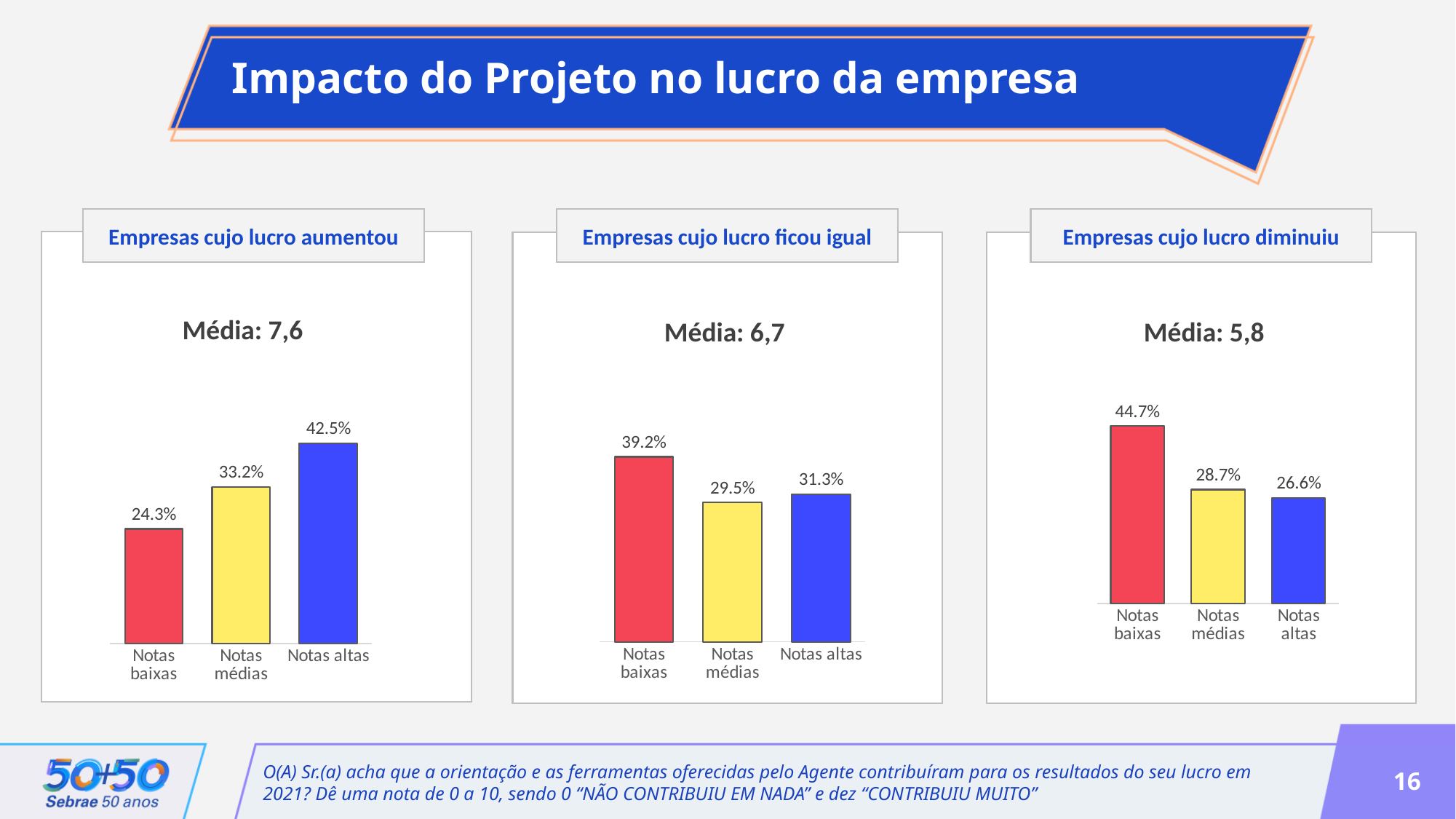
In the chart 'Empresas cujo lucro aumentou', which category has the highest value? Notas altas In the chart 'Empresas cujo lucro aumentou', what is the value for Notas altas? 42.5% In the chart 'Empresas cujo lucro ficou igual', which category has the highest value? Notas baixas How many categories does the chart 'Empresas cujo lucro aumentou' show? 3 What kind of chart is 'Empresas cujo lucro diminuiu'? Bar chart In the chart 'Empresas cujo lucro aumentou', what is the difference between Notas altas and Notas baixas? 18.2% In the chart 'Empresas cujo lucro aumentou', do the values rise or fall from Notas baixas to Notas altas? Rise In the chart 'Empresas cujo lucro ficou igual', which is larger: Notas médias or Notas altas? Notas altas In the chart 'Empresas cujo lucro diminuiu', what is the difference between Notas baixas and Notas altas? 18.1% In the chart 'Empresas cujo lucro ficou igual', what is the value for Notas baixas? 39.2% In the chart 'Empresas cujo lucro diminuiu', what is the value for Notas médias? 28.7% In the chart 'Empresas cujo lucro diminuiu', which category has the lowest value? Notas altas